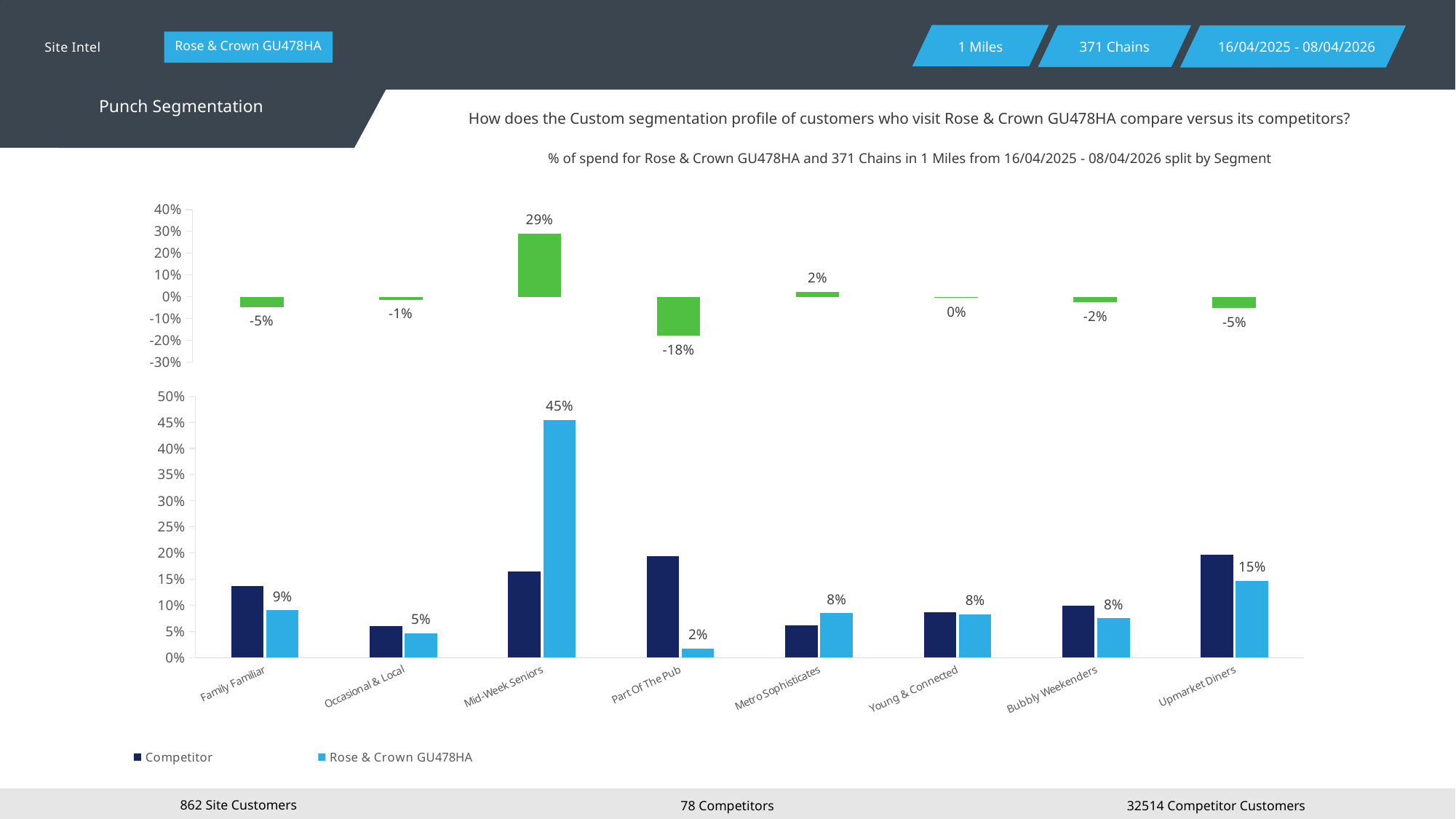
In the bottom chart, which segment has the lowest Rose & Crown GU478HA value? Part Of The Pub In the bottom chart, is the Competitor value for Upmarket Diners greater or less than 15%? greater In the top chart, what is the value shown for Mid-Week Seniors? 29% How many series does the legend of the bottom chart list? 2 In the bottom chart, what is the value for Rose & Crown GU478HA in the Mid-Week Seniors segment? 45% How many segments are shown on the x axis of the bottom chart? 8 In the top chart, what is the value shown for Part Of The Pub? -18% In the bottom chart, which is larger for Part Of The Pub: the Competitor value or the Rose & Crown GU478HA value? Competitor In the bottom chart, which segment has the highest Rose & Crown GU478HA value? Mid-Week Seniors In the bottom chart, what is the value for Rose & Crown GU478HA in the Upmarket Diners segment? 15% In the bottom chart, what is the difference between the Rose & Crown GU478HA values for Mid-Week Seniors and Upmarket Diners? 30% In the top chart, which segment has the lowest value? Part Of The Pub